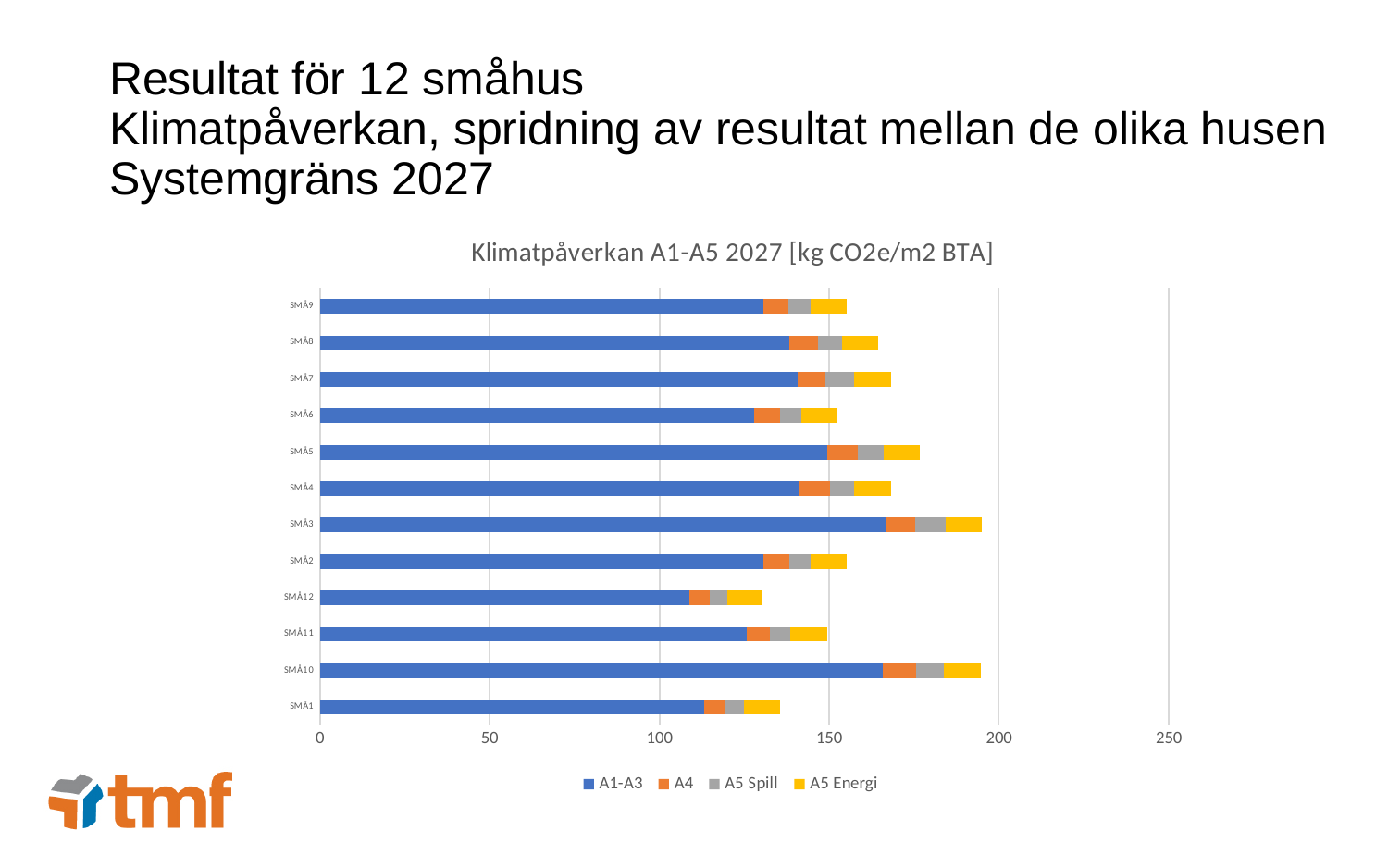
Which series is shown in blue in the chart? A1-A3 What kind of chart is shown on the slide? Stacked bar chart Which has the larger total value, SMÅ5 or SMÅ6? SMÅ5 Is the total value for SMÅ5 greater or less than 150? greater Which has the larger total value, SMÅ3 or SMÅ12? SMÅ3 Is the total value for SMÅ12 greater or less than 150? less How many houses (categories) are plotted in the chart? 12 What is the title of the chart? Klimatpåverkan A1-A5 2027 [kg CO2e/m2 BTA] Is the A1-A3 value for SMÅ10 greater or less than 150? greater How many series does the legend list? 4